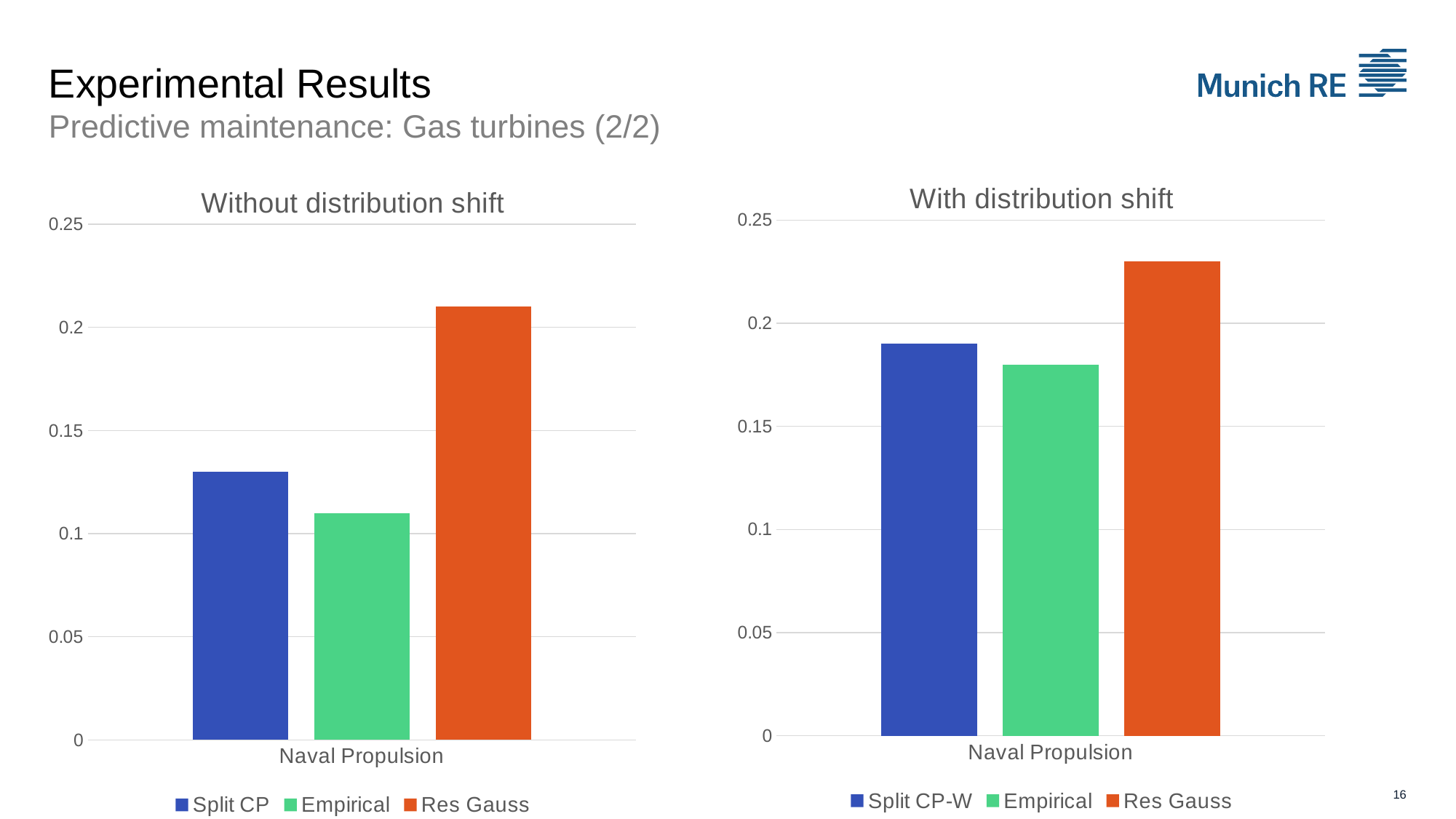
In the 'Without distribution shift' chart, is the value for Split CP greater or less than 0.15? less In the 'Without distribution shift' chart, which series has the lowest value for Naval Propulsion? Empirical In the 'Without distribution shift' chart, which series has the highest value for Naval Propulsion? Res Gauss In the 'With distribution shift' chart, which series has the highest value for Naval Propulsion? Res Gauss How many series does the legend of the 'With distribution shift' chart list? 3 In the 'With distribution shift' chart, is the value for Res Gauss greater or less than 0.2? greater What kind of chart is the 'Without distribution shift' chart? Bar chart In the 'With distribution shift' chart, is the value for Split CP-W greater or less than 0.2? less In the 'Without distribution shift' chart, which is larger, the value for Split CP or the value for Empirical? Split CP In the 'With distribution shift' chart, which is larger, the value for Res Gauss or the value for Empirical? Res Gauss What is the category label on the x axis of the 'With distribution shift' chart? Naval Propulsion